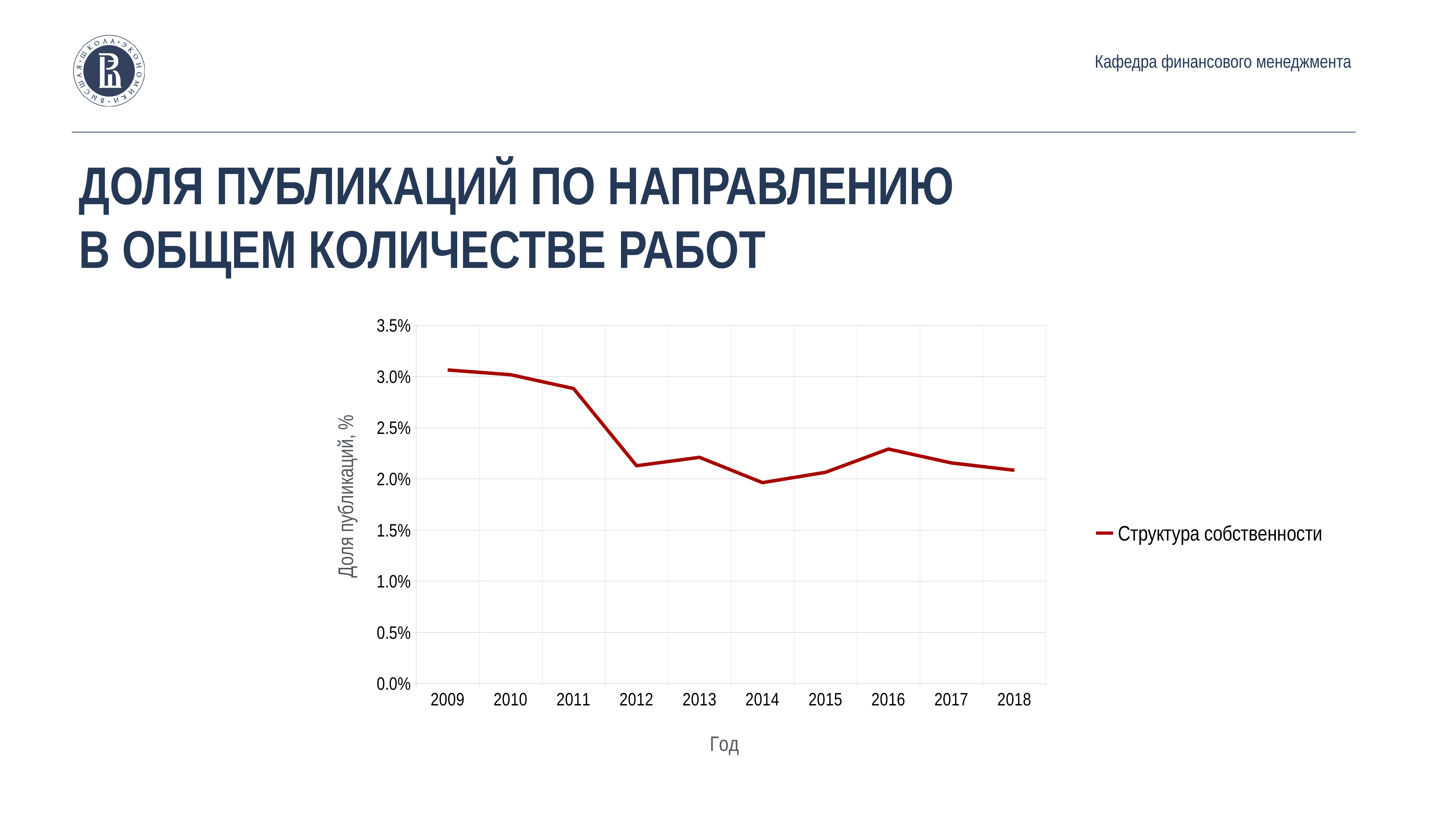
Is the value for 2009 greater or less than 2.5%? greater Is the value for 2011 greater or less than 2.5%? greater Which year has the larger value, 2011 or 2012? 2011 What is the name of the series shown in the legend? Структура собственности Is the value for 2014 greater or less than 2.5%? less What kind of chart is shown on the slide? line chart How many series does the legend list? 1 Overall, does the share of publications rise or fall from 2009 to 2018? fall What is the title of the y axis? Доля публикаций, % In which year is the share of publications lowest? 2014 How many years are plotted along the x axis? 10 In which year is the share of publications highest? 2009